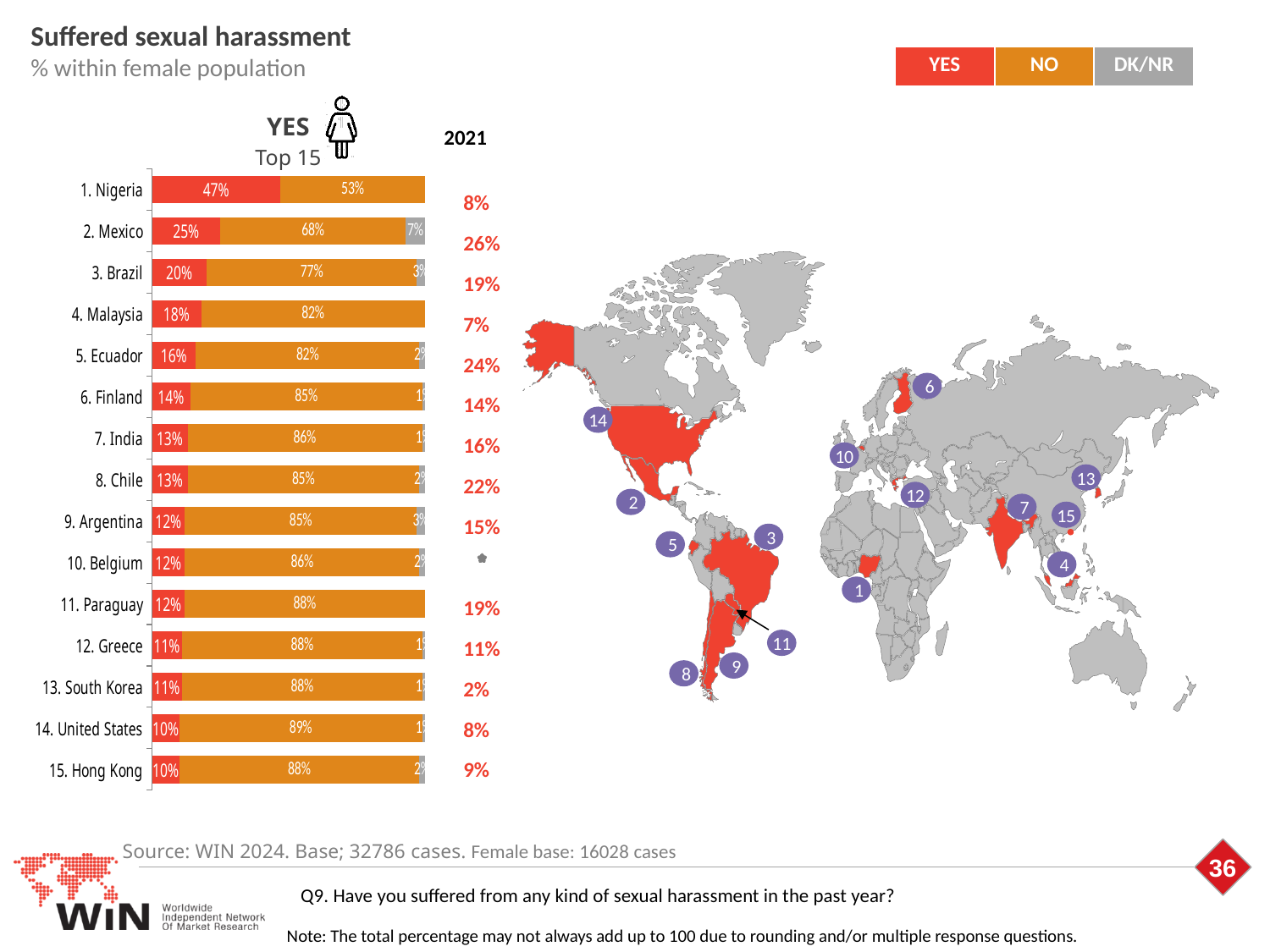
Which country has the lowest NO value? Nigeria What is the NO value for Brazil? 77% Which is larger, the YES value for Brazil or the YES value for Malaysia? Brazil How many series does the legend list? 3 What is the YES value for Nigeria? 47% Which colour represents the YES series in the legend? Red What is the difference between the YES values for Nigeria and Mexico? 22% What is the NO value for the United States? 89% What kind of chart is used to show the YES/NO/DK/NR results? Stacked bar chart How many countries are shown in the bar chart? 15 What is the DK/NR value for Mexico? 7% Which country has the highest YES value? Nigeria